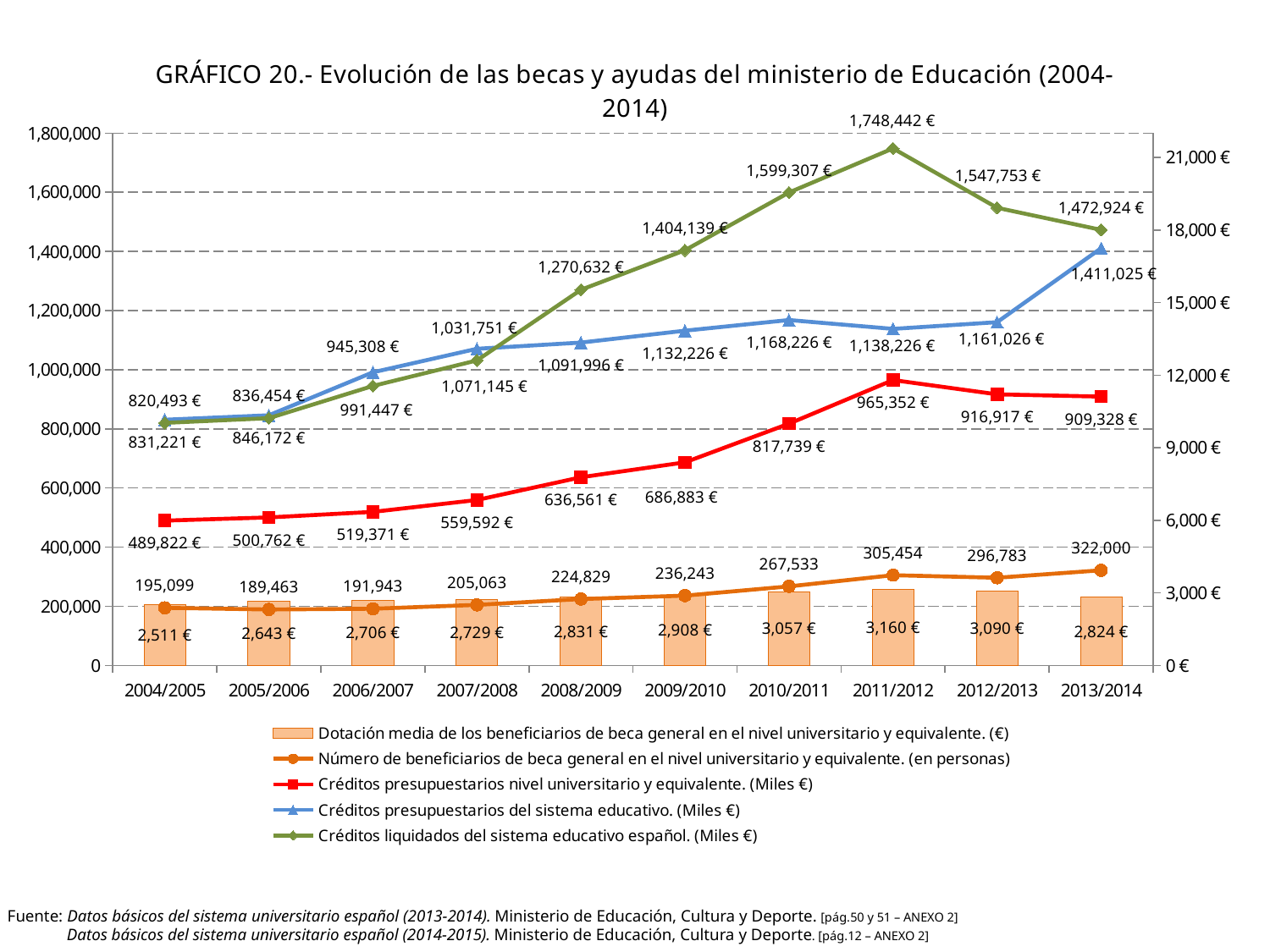
What is the value of 'Créditos presupuestarios del sistema educativo' for 2013/2014? 1,411,025 € What is the difference between 'Créditos presupuestarios nivel universitario y equivalente' in 2011/2012 and in 2010/2011? 147,613 € Does 'Créditos presupuestarios nivel universitario y equivalente' rise or fall from 2004/2005 to 2011/2012? Rise In 2013/2014, which is larger: 'Créditos presupuestarios del sistema educativo' or 'Créditos liquidados del sistema educativo español'? Créditos liquidados del sistema educativo español In which academic year is 'Créditos liquidados del sistema educativo español' highest? 2011/2012 What kind of chart is shown on the slide? A combined bar and line chart What is the value of 'Dotación media de los beneficiarios de beca general' for 2011/2012? 3,160 € How many academic years are shown on the x axis? 10 What is the title of the chart? GRÁFICO 20.- Evolución de las becas y ayudas del ministerio de Educación (2004-2014) In which academic year is 'Dotación media de los beneficiarios de beca general' lowest? 2004/2005 How many series does the legend list? 5 What is the 'Número de beneficiarios de beca general' for 2013/2014? 322,000